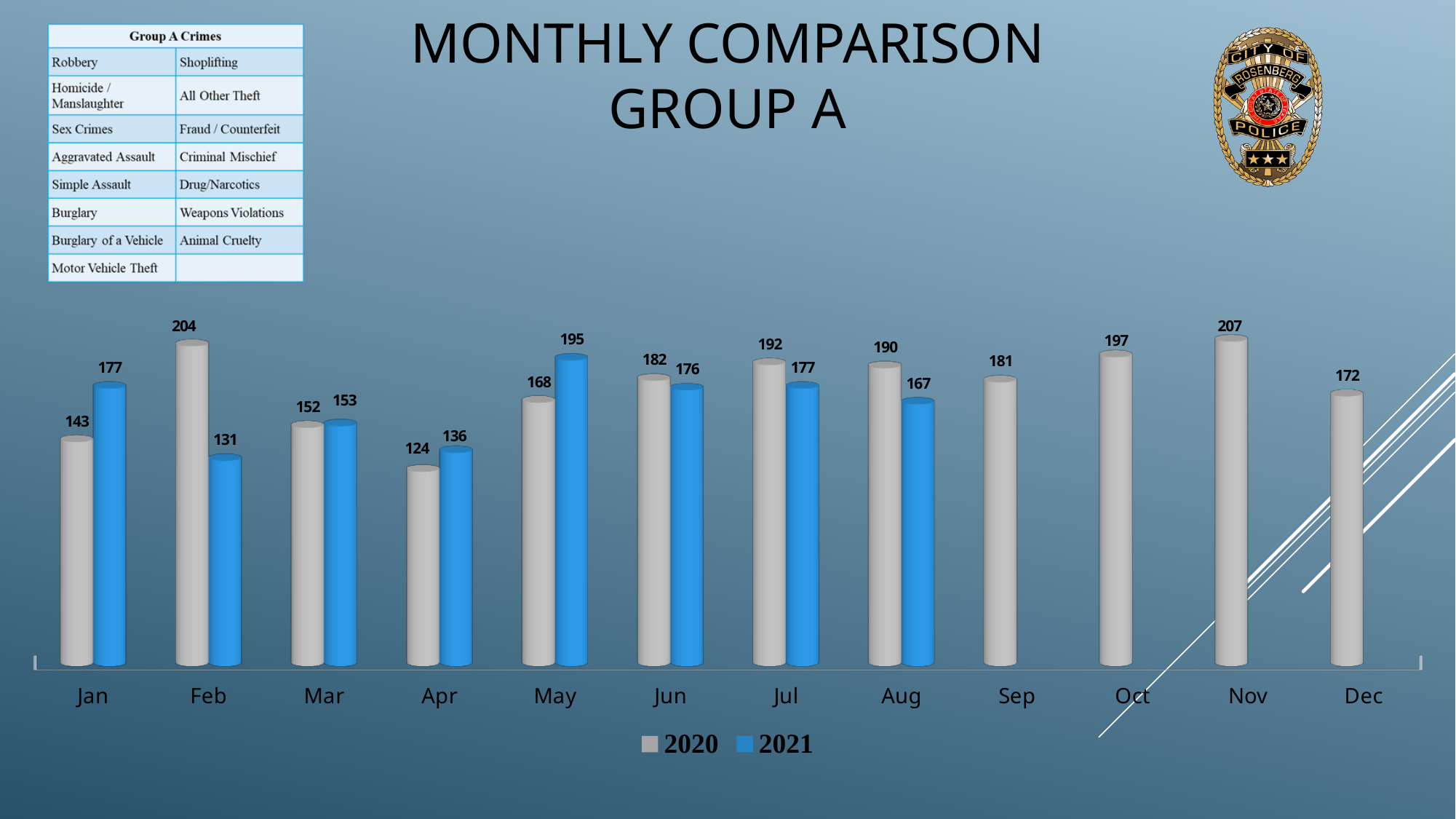
What is the 2020 value for Feb? 204 What is the 2021 value for May? 195 What is the 2020 value for Dec? 172 How many months are shown on the x axis? 12 What kind of chart is shown on the slide? bar chart What is the difference between the 2020 and 2021 values for Jan? 34 Which month has the lowest 2020 value? Apr Which month has the highest 2020 value? Nov Which is larger for Apr, the 2020 value or the 2021 value? 2021 What colour are the 2021 bars? blue How many series does the legend list? 2 Which month has the lowest 2021 value? Feb